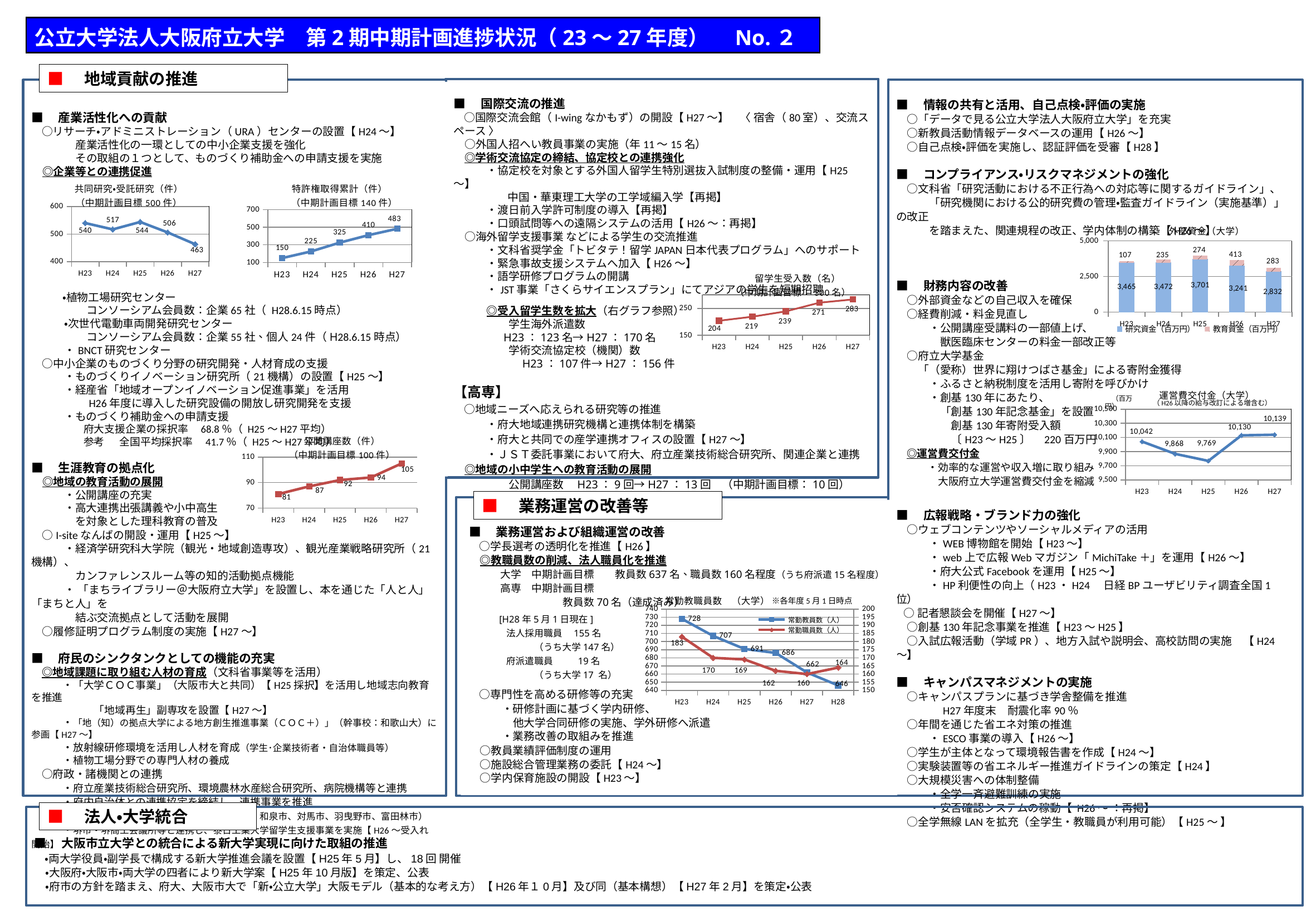
In the 特許権取得累計（件） chart, what is the difference between the H27 and H23 values? 333 In the 外部資金（大学） chart, what is the total of the H26 stacked bar? 3,654 In the 共同研究・受託研究（件） chart, which year has the highest value? H25 In the 特許権取得累計（件） chart, do the values rise or fall from H23 to H27? rise In the 特許権取得累計（件） chart, what is the value for H25? 325 In the 常勤教職員数（大学） chart, how many series does the legend list? 2 In the 外部資金（大学） chart, what is the 研究資金（百万円） value for H25? 3,701 In the 共同研究・受託研究（件） chart, what is the value for H27? 463 In the 公開講座数（件） chart, what is the value for H27? 105 In the 運営費交付金（大学） chart, which year has the lowest value? H25 In the 留学生受入数（名） chart, how many data points are plotted? 5 In the 留学生受入数（名） chart, which year has the lowest value? H23